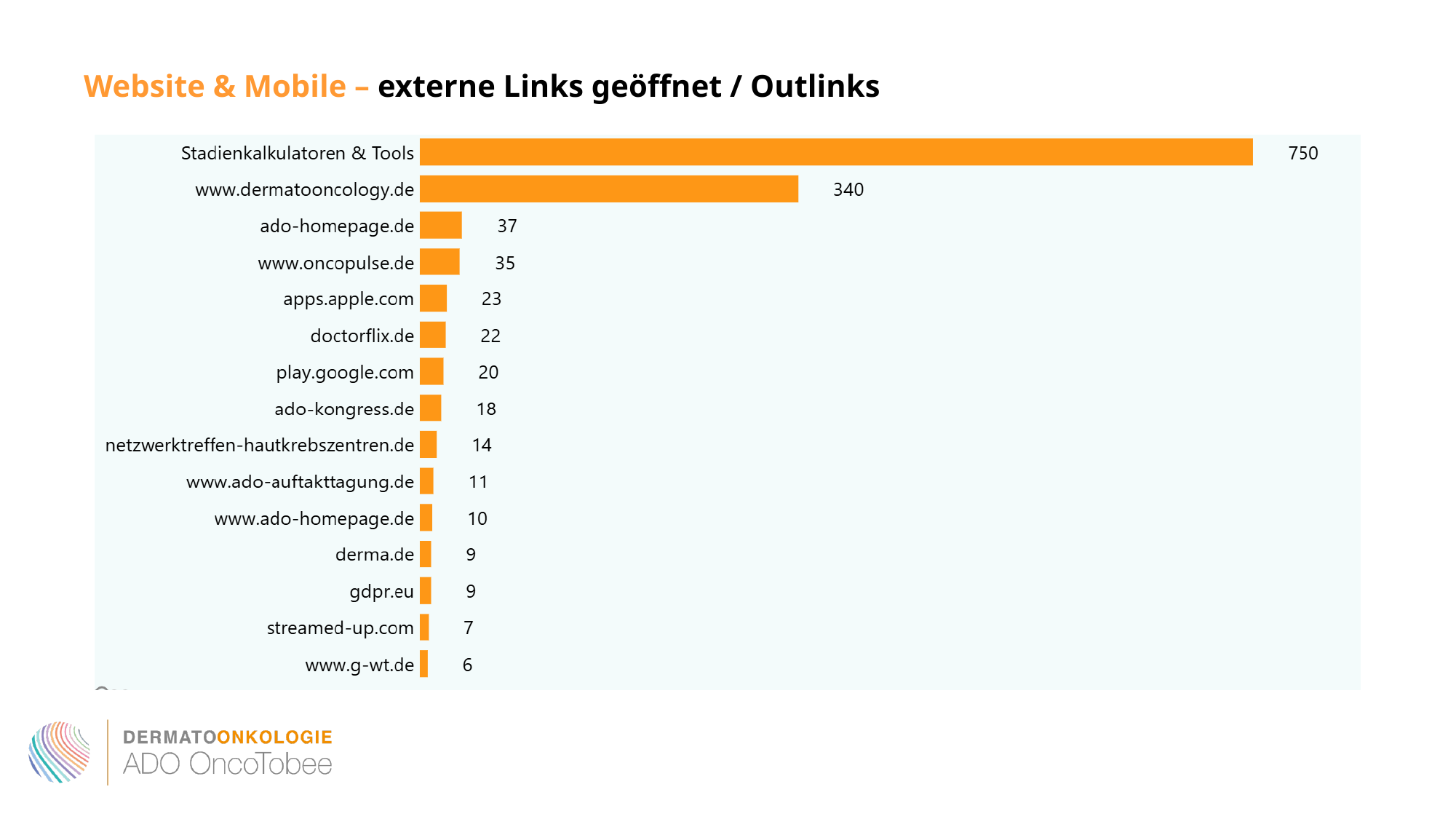
What kind of chart is shown on the slide? bar chart Which category has the lowest value? www.g-wt.de Which category has the highest value? Stadienkalkulatoren & Tools What is the difference between the values for Stadienkalkulatoren & Tools and www.dermatooncology.de? 410 What is the value for apps.apple.com? 23 What is the difference between the values for ado-homepage.de and www.ado-homepage.de? 27 What is the value for www.dermatooncology.de? 340 What is the value for netzwerktreffen-hautkrebszentren.de? 14 What colour are the bars in the chart? orange What is the value for Stadienkalkulatoren & Tools? 750 Which has a larger value, doctorflix.de or play.google.com? doctorflix.de How many categories are shown in the chart? 15